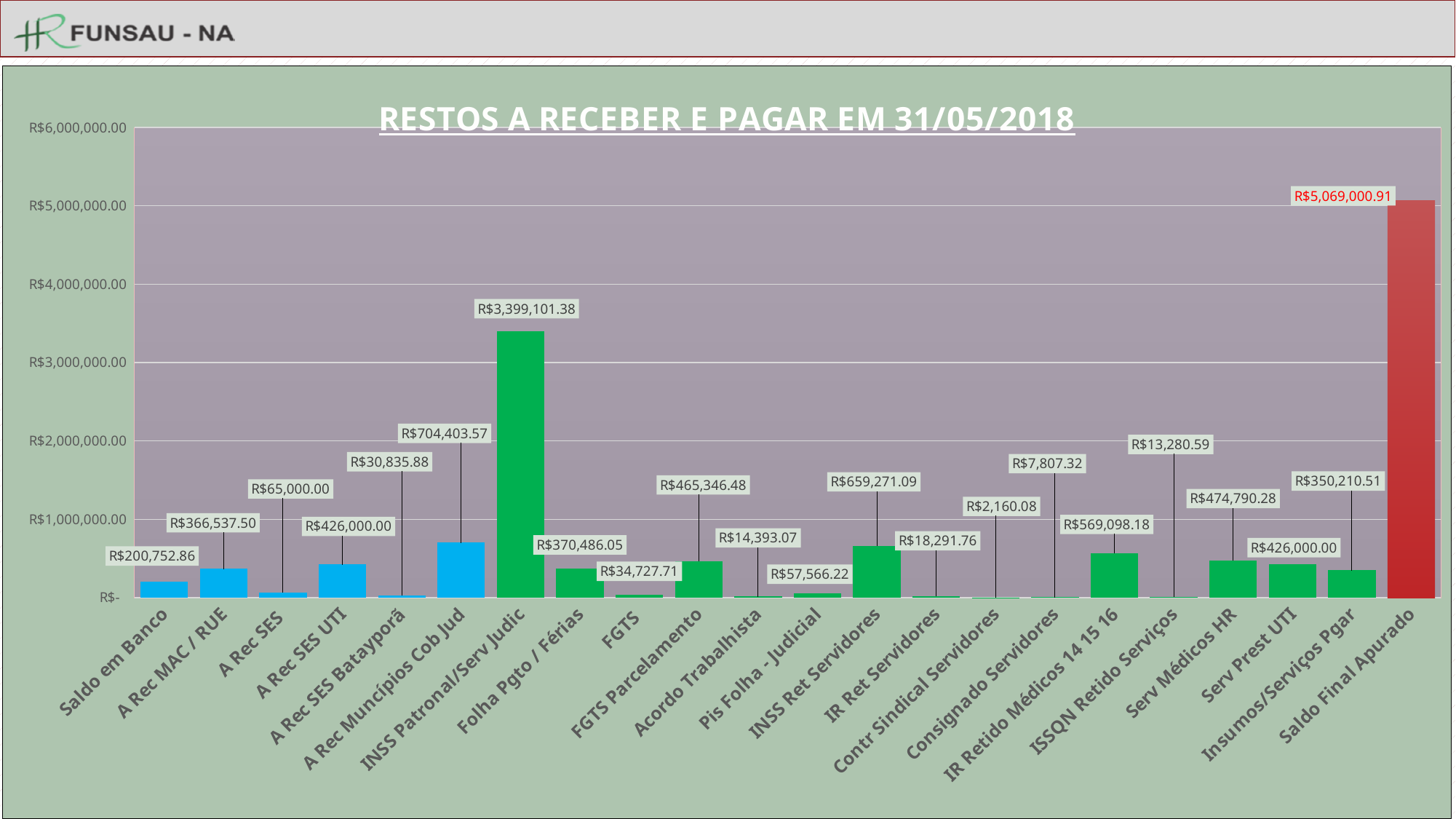
Which category has the highest value? Saldo Final Apurado What is the title of the chart? RESTOS A RECEBER E PAGAR EM 31/05/2018 What is the difference between Saldo Final Apurado and INSS Patronal/Serv Judic? R$1,669,899.53 What is the value for IR Retido Médicos 14 15 16? R$569,098.18 What kind of chart is shown on the slide? bar chart Which category has the lowest value? Contr Sindical Servidores How many categories are shown on the x axis? 22 What is the value for A Rec Muncípios Cob Jud? R$704,403.57 What is the value for INSS Patronal/Serv Judic? R$3,399,101.38 Is the value for INSS Patronal/Serv Judic greater or less than R$3,000,000.00? greater Which is larger, IR Retido Médicos 14 15 16 or Serv Prest UTI? IR Retido Médicos 14 15 16 What is the value for Saldo em Banco? R$200,752.86